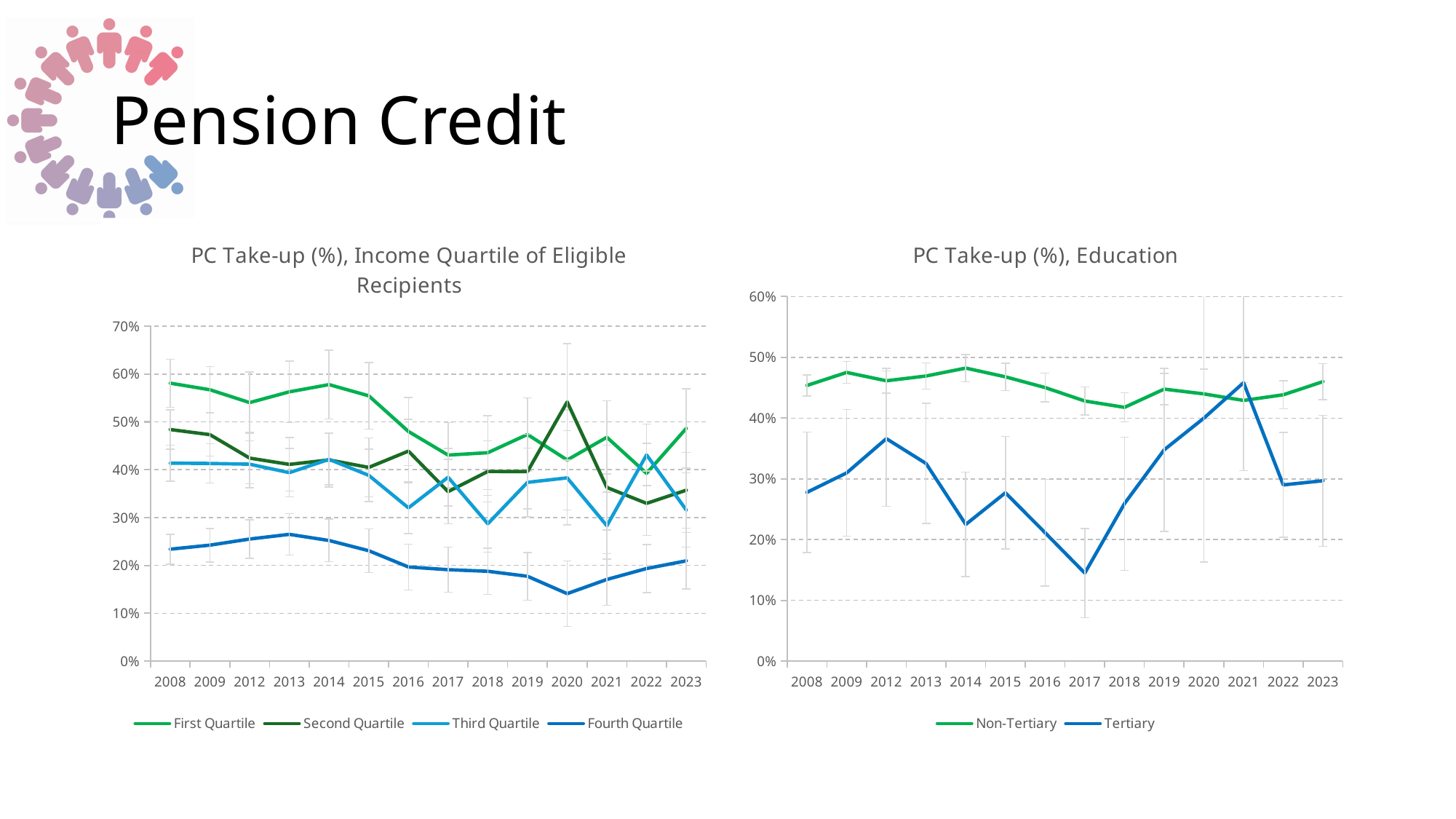
How many series does the legend of the 'PC Take-up (%), Income Quartile of Eligible Recipients' chart list? 4 In the 'PC Take-up (%), Income Quartile of Eligible Recipients' chart, is the First Quartile value for 2008 greater or less than 50%? greater What kind of chart is the 'PC Take-up (%), Income Quartile of Eligible Recipients' chart? Line chart How many years are plotted on the x axis of the 'PC Take-up (%), Education' chart? 14 What are the two series listed in the legend of the 'PC Take-up (%), Education' chart? Non-Tertiary and Tertiary In the 'PC Take-up (%), Income Quartile of Eligible Recipients' chart, in which year is the Fourth Quartile value lowest? 2020 In the 'PC Take-up (%), Education' chart, in which year is the Tertiary value lowest? 2017 In the 'PC Take-up (%), Income Quartile of Eligible Recipients' chart, which is larger in 2020: First Quartile or Second Quartile? Second Quartile In the 'PC Take-up (%), Education' chart, does the Tertiary line rise or fall from 2017 to 2021? Rise In the 'PC Take-up (%), Education' chart, in which year is the Tertiary value highest? 2021 In the 'PC Take-up (%), Income Quartile of Eligible Recipients' chart, is the Fourth Quartile value for 2020 greater or less than 20%? less In the 'PC Take-up (%), Education' chart, is the Tertiary value for 2017 greater or less than 20%? less